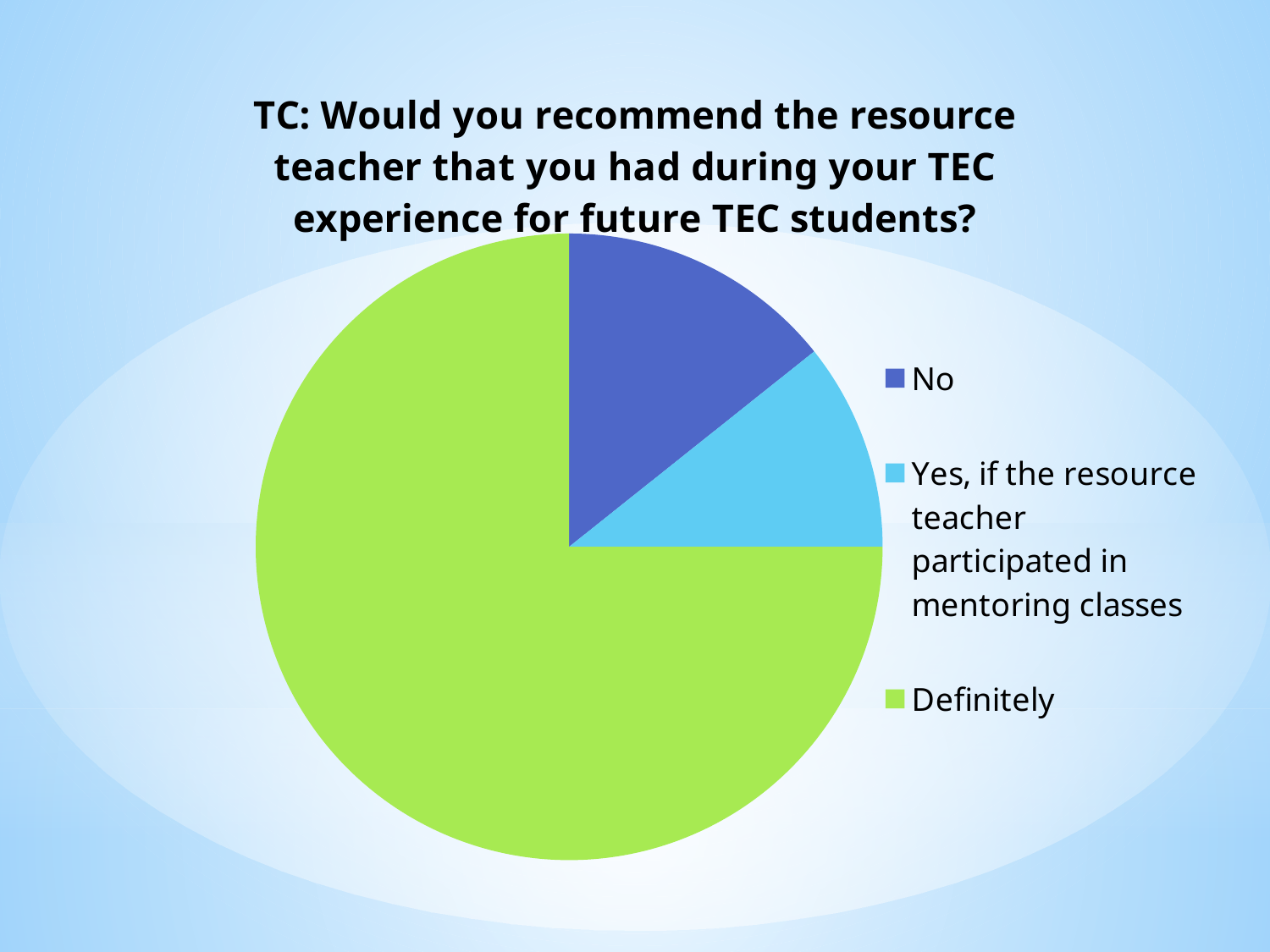
Does the "Definitely" slice take up more or less than half of the pie? more Which response has the largest share of the pie? Definitely How many entries does the legend list? 3 Which slice is larger: "Definitely" or "No"? Definitely What is the title of the chart? TC: Would you recommend the resource teacher that you had during your TEC experience for future TEC students? What colour is the "Definitely" slice? green What kind of chart is shown on the slide? pie chart How many slices does the pie chart have? 3 Which response has the smallest share of the pie? Yes, if the resource teacher participated in mentoring classes Which slice is larger: "No" or "Yes, if the resource teacher participated in mentoring classes"? No